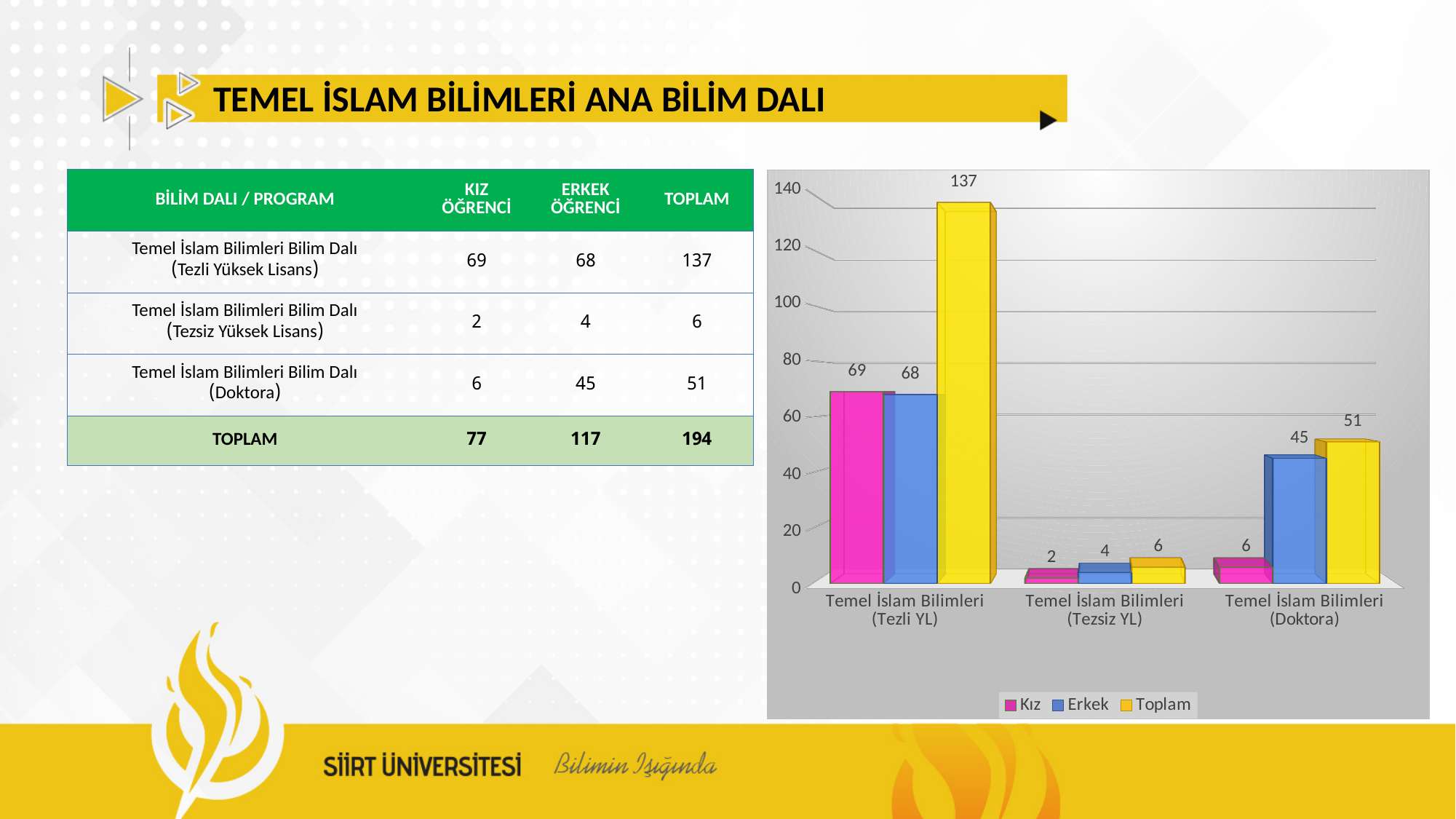
What is the Kız value for Temel İslam Bilimleri (Doktora)? 6 What is the Toplam value for Temel İslam Bilimleri (Tezli YL)? 137 How many categories are shown on the x axis of the chart? 3 What kind of chart is shown on the slide? bar chart Which category has the highest Toplam value? Temel İslam Bilimleri (Tezli YL) How many series does the chart legend list? 3 What is the Erkek value for Temel İslam Bilimleri (Tezsiz YL)? 4 Which is larger for Temel İslam Bilimleri (Tezli YL): the Kız value or the Erkek value? Kız Is the Toplam value for Temel İslam Bilimleri (Doktora) greater or less than 60? less Which colour represents the Toplam series in the chart? yellow Which category has the lowest Erkek value? Temel İslam Bilimleri (Tezsiz YL) What is the difference between the Erkek and Kız values for Temel İslam Bilimleri (Doktora)? 39